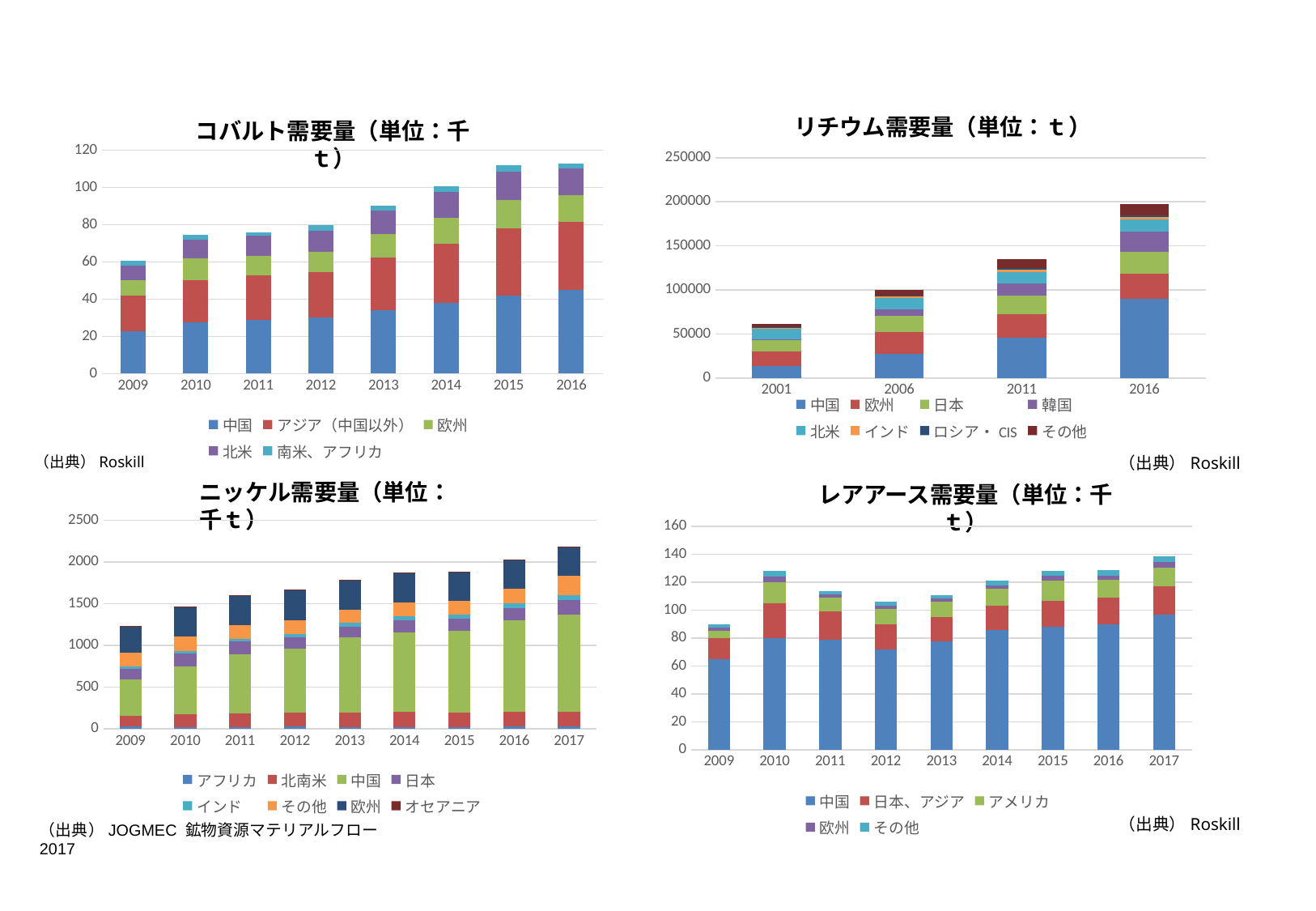
In the リチウム需要量 chart, is the total for 2016 greater or less than 150000? greater How many years are shown on the x axis of the コバルト需要量 chart? 8 In the ニッケル需要量 chart, is the total for 2009 greater or less than 1500? less How many series does the legend of the リチウム需要量 chart list? 8 In the コバルト需要量 chart, is the total for 2016 greater or less than 100? greater How many series does the legend of the コバルト需要量 chart list? 5 In the コバルト需要量 chart, which year has the lowest total stacked bar? 2009 In the レアアース需要量 chart, which year has the highest total stacked bar? 2017 How many years are shown on the x axis of the ニッケル需要量 chart? 9 In the リチウム需要量 chart, which year has the highest total stacked bar? 2016 Which series is listed first in the legend of the レアアース需要量 chart? 中国 What kind of chart is the コバルト需要量 chart at the top left? stacked bar chart